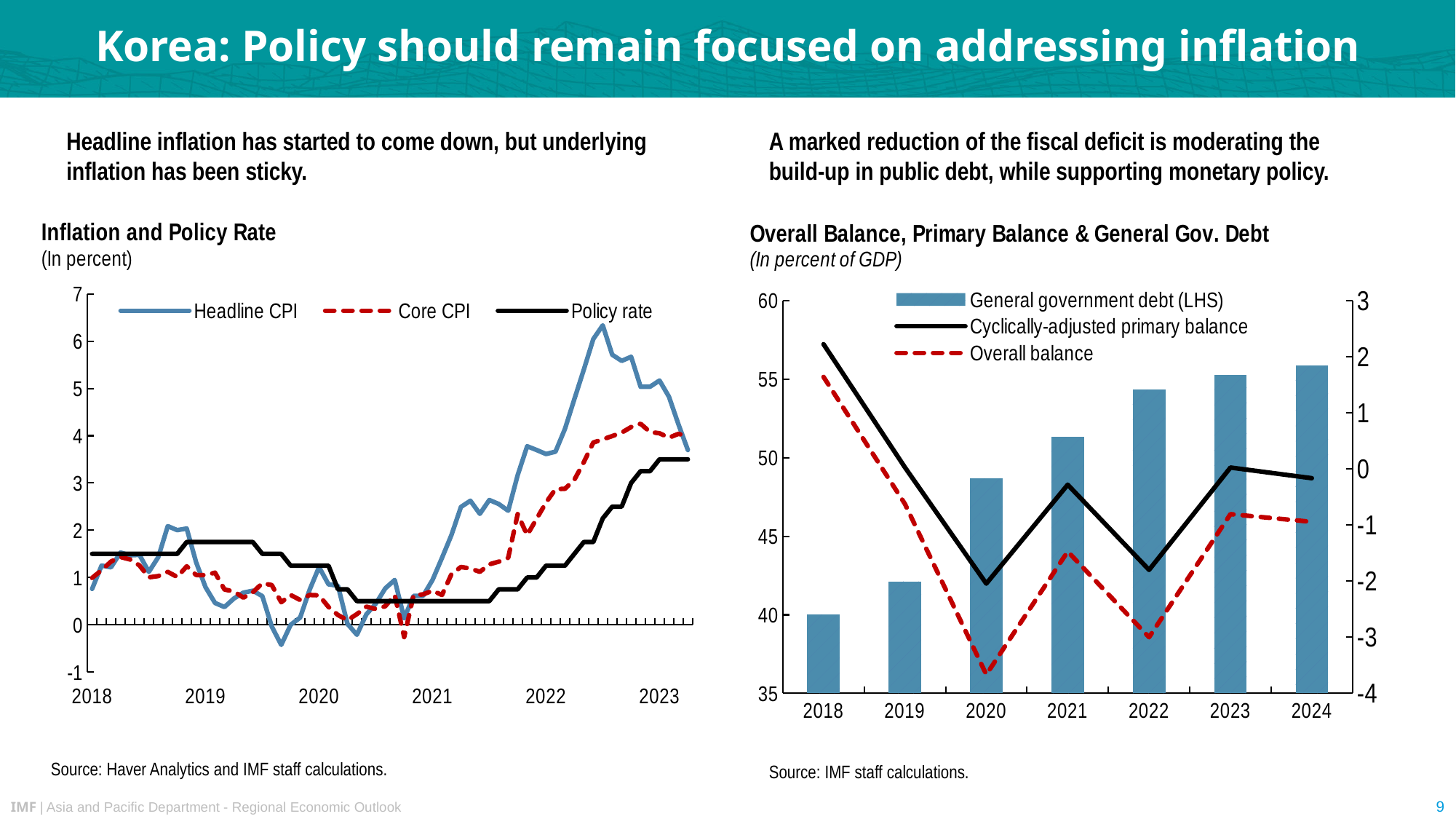
On the 'Inflation and Policy Rate' chart, is the Policy rate at the end of the series in 2023 greater or less than 4? less On the 'Overall Balance, Primary Balance & General Gov. Debt' chart, is the General government debt in 2020 greater or less than 50? less On the 'Overall Balance, Primary Balance & General Gov. Debt' chart, is the Overall balance in 2020 lower or higher than in 2022? lower On the 'Overall Balance, Primary Balance & General Gov. Debt' chart, what is the value of General government debt in 2018? 40 On the 'Overall Balance, Primary Balance & General Gov. Debt' chart, how many years are shown on the x axis? 7 On the 'Inflation and Policy Rate' chart, how many series does the legend list? 3 What kind of chart is the 'Inflation and Policy Rate' chart? Line chart On the 'Overall Balance, Primary Balance & General Gov. Debt' chart, which year has the lowest General government debt bar? 2018 On the 'Inflation and Policy Rate' chart, which series is drawn as a red dashed line? Core CPI On the 'Overall Balance, Primary Balance & General Gov. Debt' chart, do the General government debt bars rise or fall from 2018 to 2024? rise On the 'Overall Balance, Primary Balance & General Gov. Debt' chart, which year has the highest General government debt bar? 2024 On the 'Inflation and Policy Rate' chart, is the peak value of Headline CPI in 2022 greater or less than 6? greater